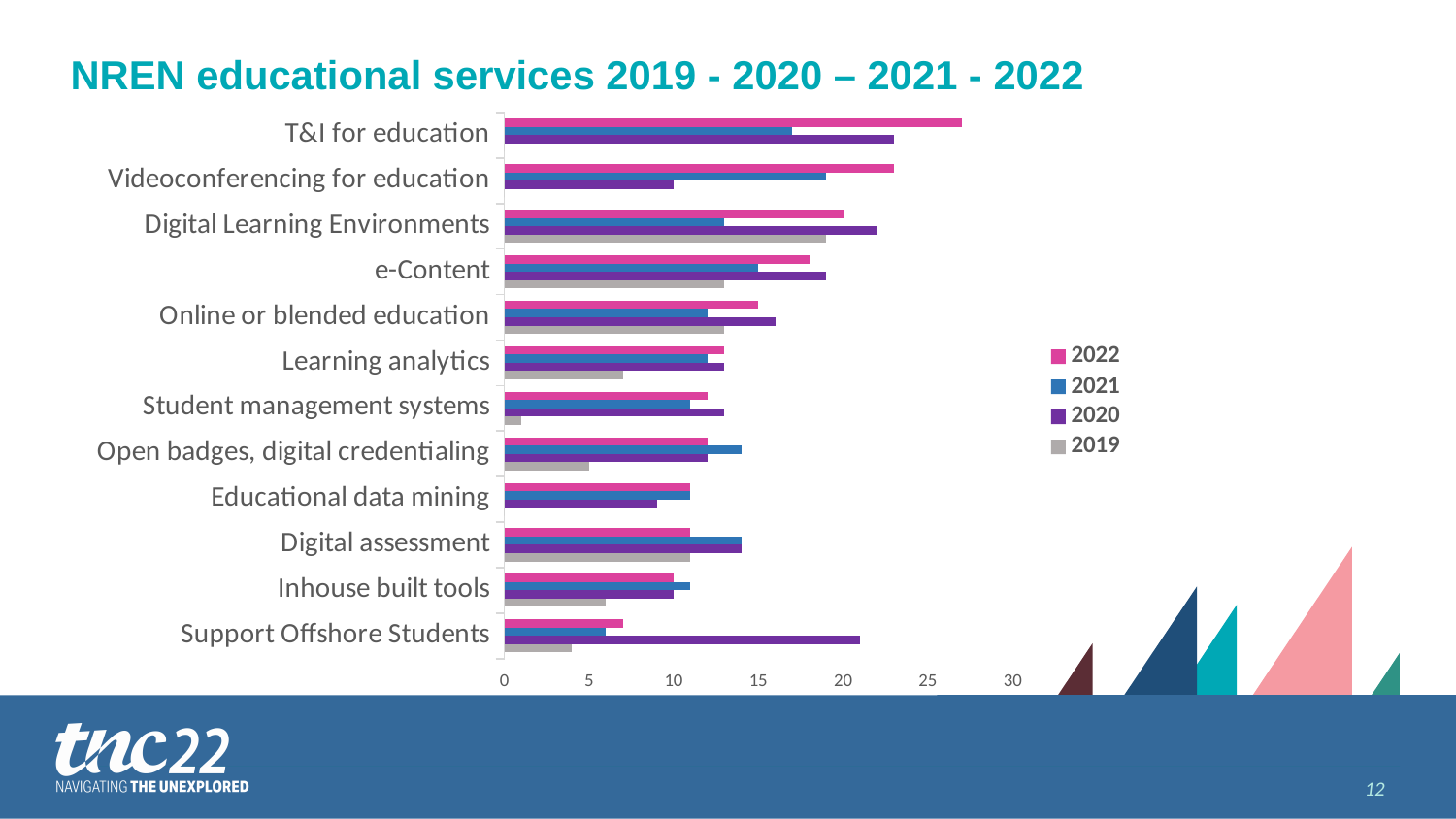
How many series does the legend list? 4 For Support Offshore Students, which is larger: the 2020 value or the 2022 value? 2020 Is the 2019 value for Learning analytics greater or less than 10? less Which category has the highest value for 2022? T&I for education Is the 2020 value for Support Offshore Students greater or less than 15? greater For Videoconferencing for education, which is larger: the 2022 value or the 2020 value? 2022 How many educational service categories are listed on the chart? 12 Is the 2022 value for T&I for education greater or less than 25? greater What is the title of the chart? NREN educational services 2019 - 2020 – 2021 - 2022 Which category has the lowest value for 2022? Support Offshore Students What kind of chart is shown on the slide? Bar chart